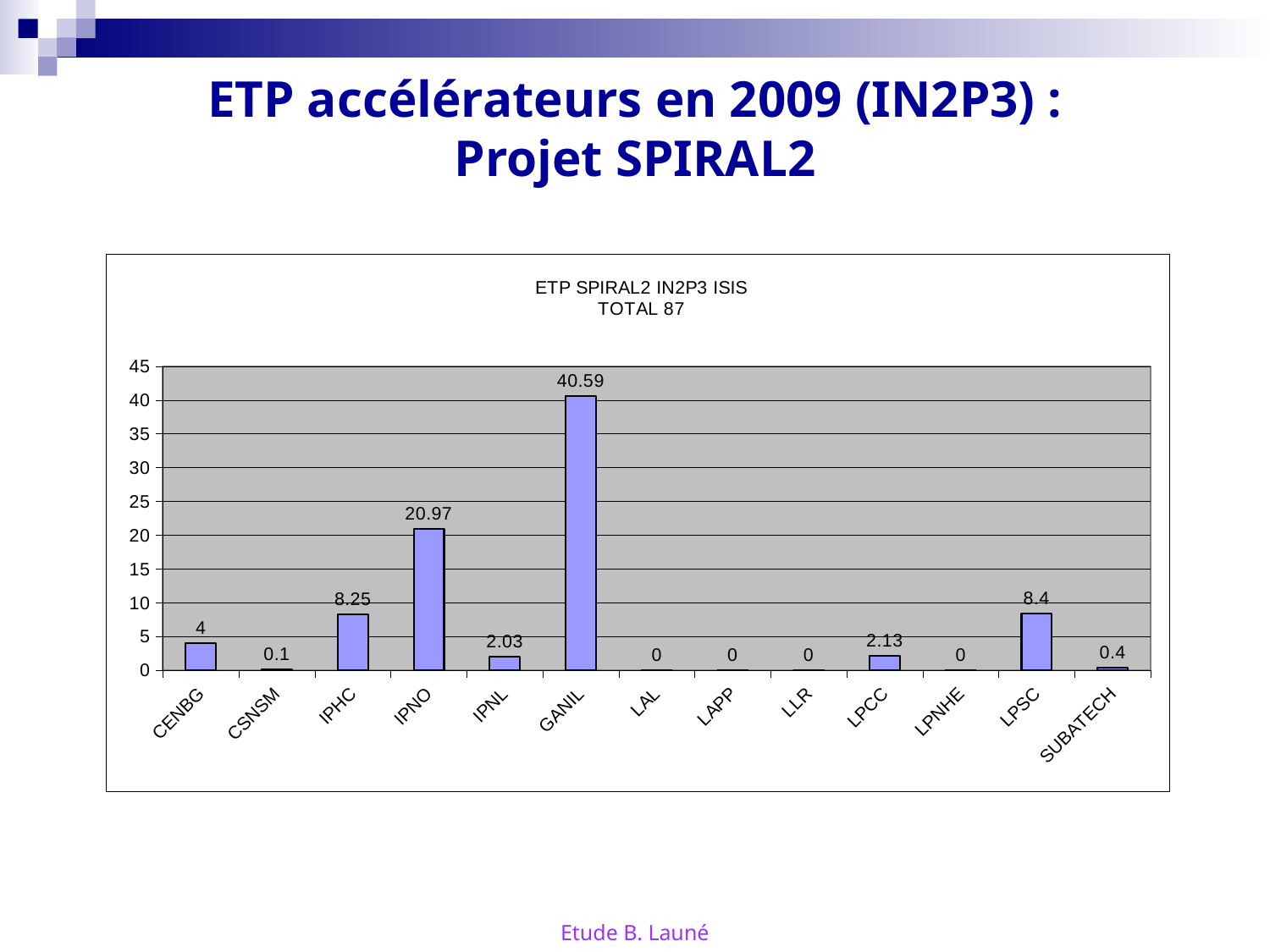
What is the value for LPSC? 8.4 What is the value for GANIL? 40.59 How many categories have a value of 0? 4 How many categories are shown on the x axis? 13 Which category has the highest value? GANIL What is the value for CSNSM? 0.1 What kind of chart is shown? bar chart What is the difference between the values for GANIL and IPNO? 19.62 What is the difference between the values for LPSC and IPHC? 0.15 What is the value for IPNO? 20.97 Which is larger, the value for CENBG or the value for IPNL? CENBG What total is stated in the chart title? 87